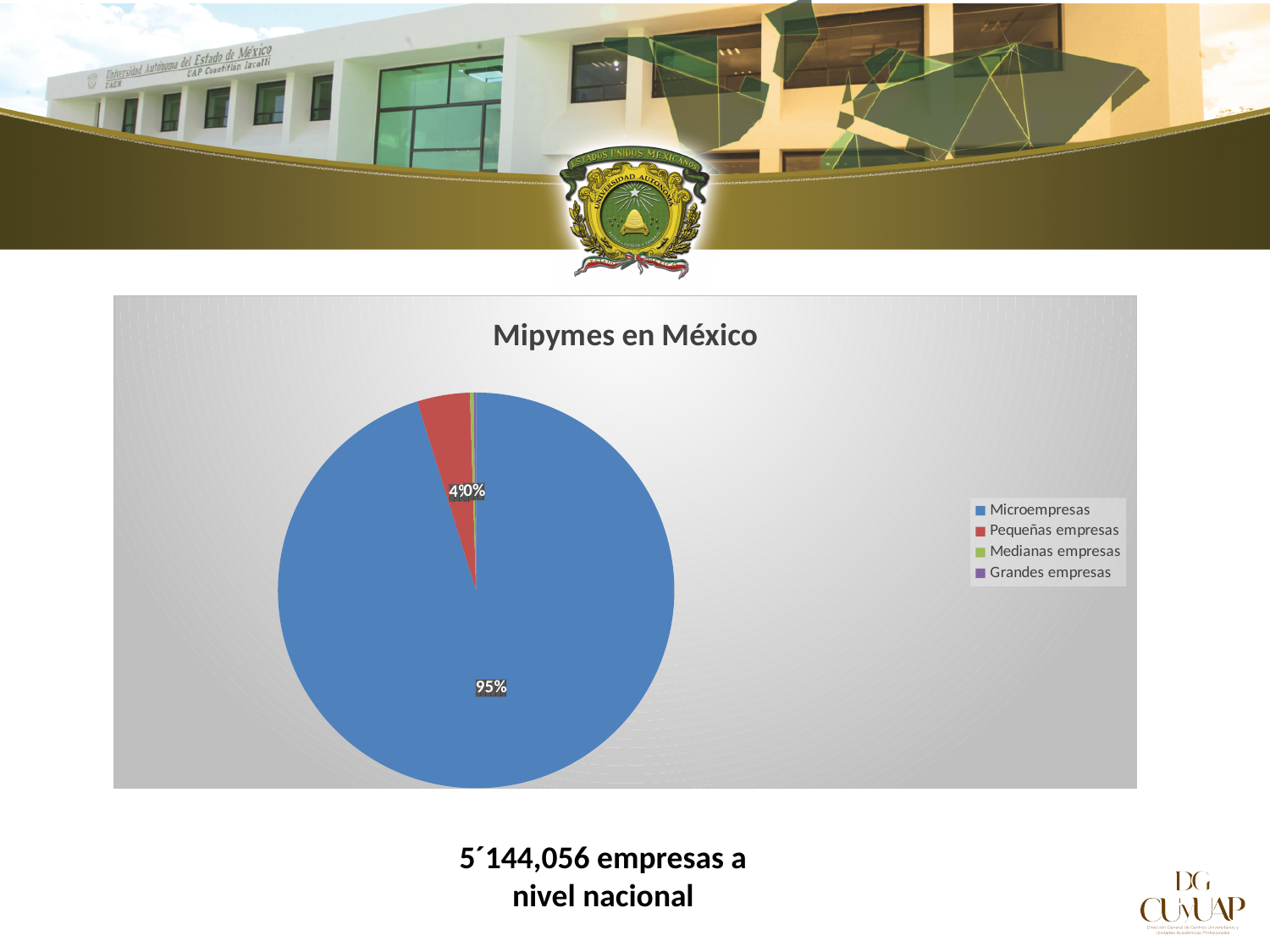
Which is larger, the slice for Microempresas or the slice for Pequeñas empresas? Microempresas What share of the pie does Microempresas represent? 95% What is the title of the chart? Mipymes en México What kind of chart is shown on the slide? pie chart What colour is the Microempresas slice in the pie chart? blue Which category has the largest slice of the pie? Microempresas What is the difference between the percentage for Microempresas and the percentage for Pequeñas empresas? 91% What percentage is shown for Pequeñas empresas? 4% Which category is listed second in the legend? Pequeñas empresas How many categories does the legend of the pie chart list? 4